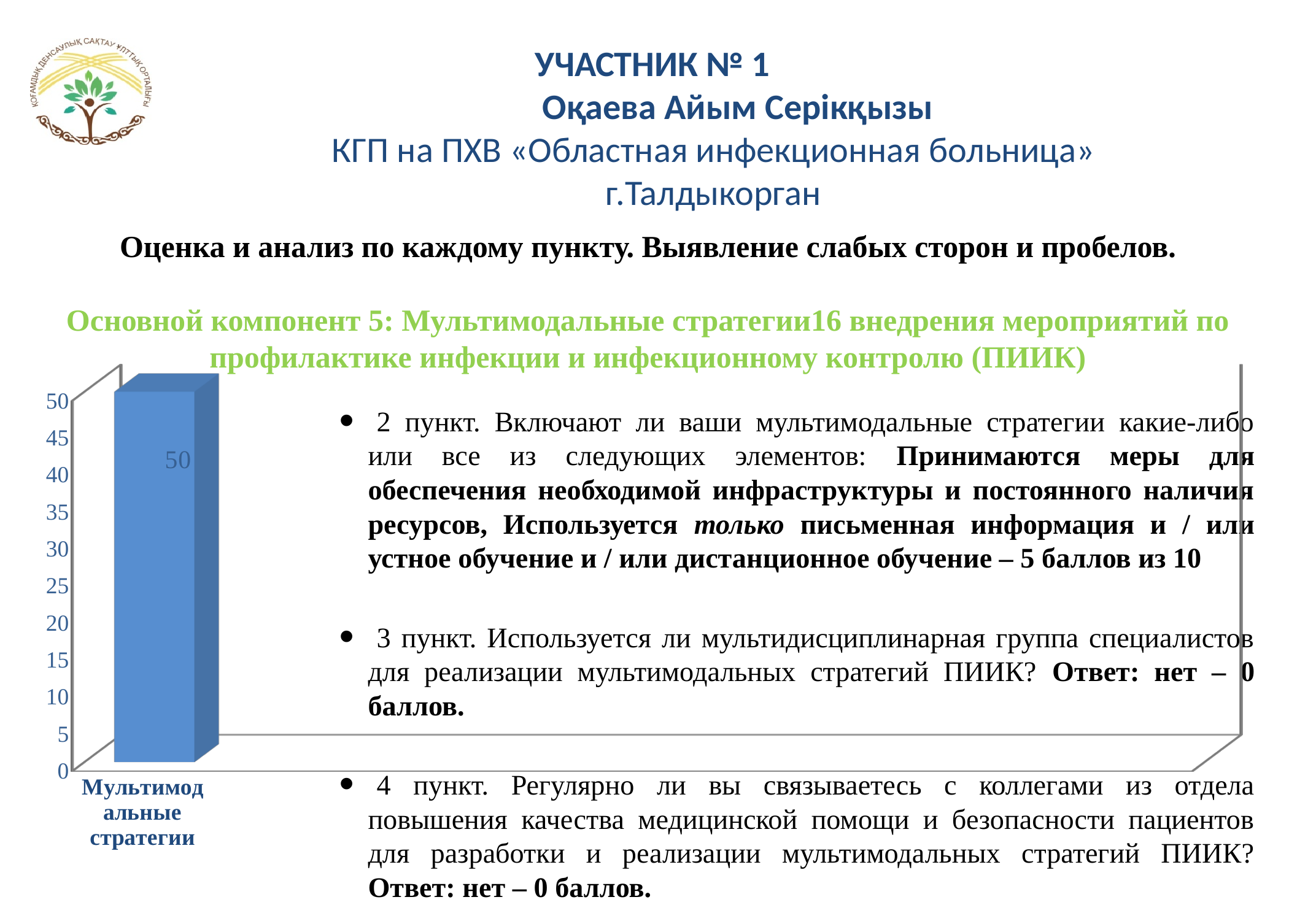
How many bars are plotted in the chart? 1 Is the value for "Мультимодальные стратегии" greater or less than 40? greater What kind of chart is shown on the slide? bar chart What is the value shown for the bar labelled "Мультимодальные стратегии"? 50 What is the highest value shown on the vertical axis of the chart? 50 What is the category label under the bar in the chart? Мультимодальные стратегии